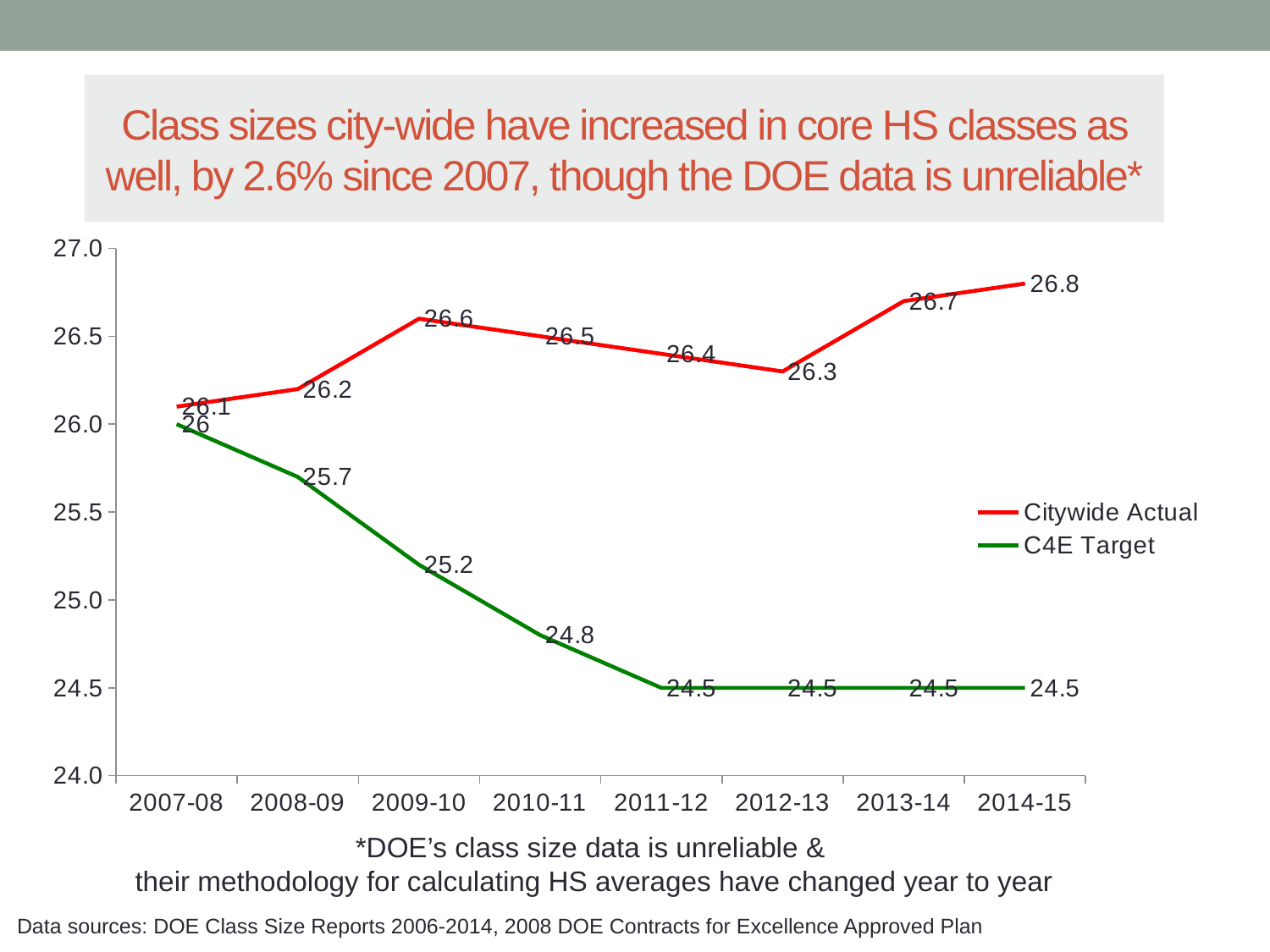
What is the Citywide Actual value for 2012-13? 26.3 In which year is the Citywide Actual value highest? 2014-15 In which year is the C4E Target value highest? 2007-08 How many series does the legend list? 2 What is the Citywide Actual value for 2014-15? 26.8 What is the C4E Target value for 2009-10? 25.2 What is the difference between the Citywide Actual and C4E Target values in 2014-15? 2.3 What colour is the line for the C4E Target series? Green How many years are shown on the x axis? 8 What kind of chart is shown on the slide? Line chart Which is larger in 2008-09, the Citywide Actual value or the C4E Target value? Citywide Actual Does the C4E Target series rise or fall from 2007-08 to 2011-12? Fall